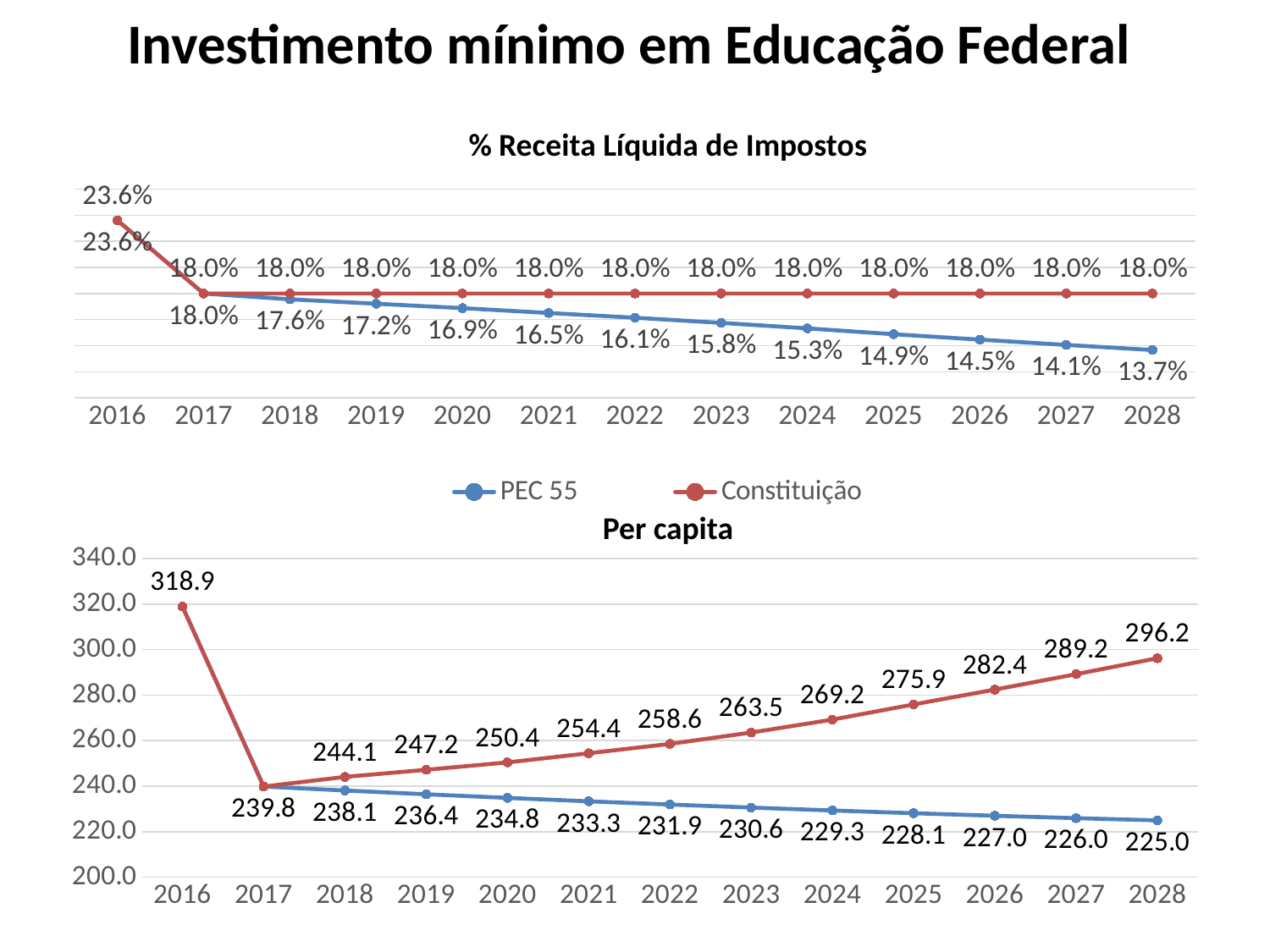
In the '% Receita Líquida de Impostos' chart, what is the difference between the Constituição and PEC 55 values in 2028? 4.3% In the '% Receita Líquida de Impostos' chart, what is the PEC 55 value for 2022? 16.1% In the '% Receita Líquida de Impostos' chart, what is the PEC 55 value for 2028? 13.7% In the 'Per capita' chart, what is the value of the red line for 2028? 296.2 In the '% Receita Líquida de Impostos' chart, what is the Constituição value for 2025? 18.0% In the 'Per capita' chart, what is the value of the blue line for 2023? 230.6 How many years are shown on the x axis of the 'Per capita' chart? 13 How many series does the legend list? 2 In the 'Per capita' chart, what is the difference between the red line and the blue line in 2028? 71.2 In the 'Per capita' chart, what is the value for 2016? 318.9 What kind of chart is the 'Per capita' chart? line chart In the '% Receita Líquida de Impostos' chart, does the PEC 55 line rise or fall from 2017 to 2028? fall